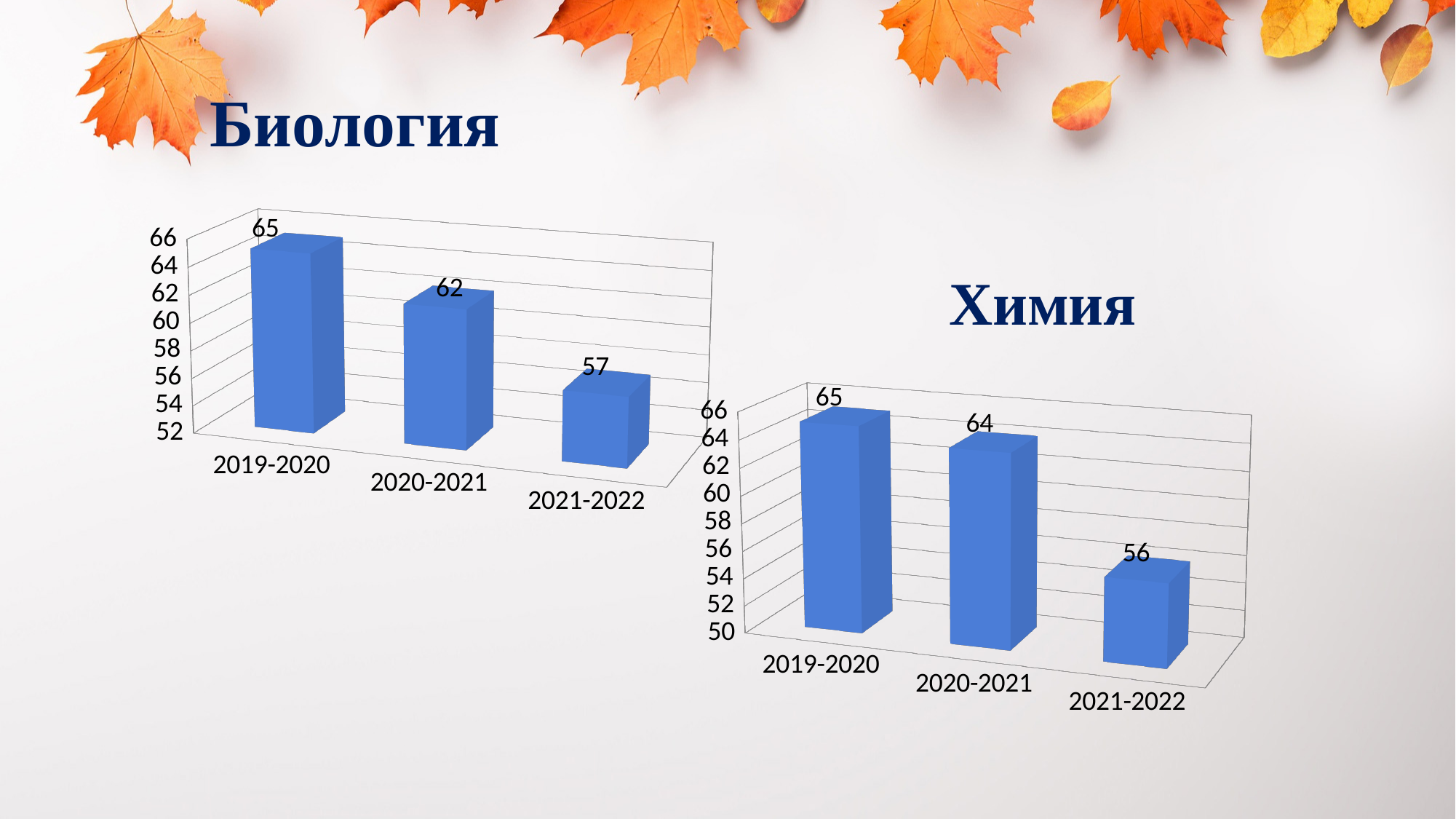
In the Биология chart, what is the difference between the values for 2019-2020 and 2021-2022? 8 In the Химия chart, what is the value for 2021-2022? 56 In the Химия chart, what is the difference between the values for 2020-2021 and 2021-2022? 8 In the Химия chart, what is the value for 2020-2021? 64 Which is larger: the 2020-2021 value in the Биология chart or the 2020-2021 value in the Химия chart? Химия In the Химия chart, which period has the highest value? 2019-2020 How many periods are shown in the Химия chart? 3 What kind of chart is the Биология chart? bar chart In the Биология chart, do the values rise or fall from 2019-2020 to 2021-2022? fall In the Биология chart, what is the value for 2019-2020? 65 In the Биология chart, what is the value for 2021-2022? 57 In the Биология chart, which period has the lowest value? 2021-2022